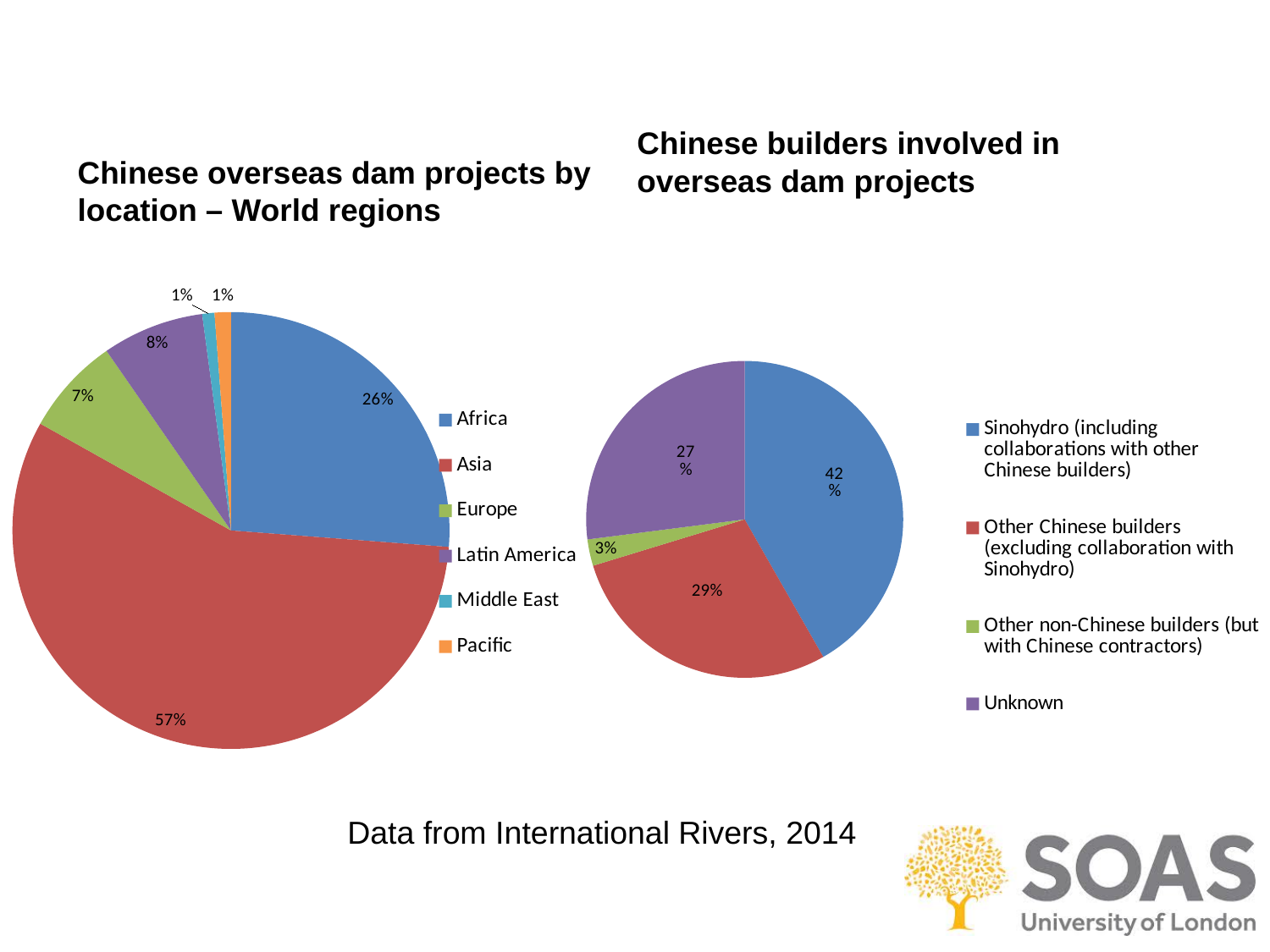
In the 'Chinese overseas dam projects by location – World regions' chart, what share of projects is in Asia? 57% In the 'Chinese builders involved in overseas dam projects' chart, which category has the smallest share? Other non-Chinese builders (but with Chinese contractors) In the 'Chinese overseas dam projects by location – World regions' chart, what share of projects is in Africa? 26% In the 'Chinese builders involved in overseas dam projects' chart, what share is Unknown? 27% In the 'Chinese overseas dam projects by location – World regions' chart, which has the larger share, Europe or Latin America? Latin America In the 'Chinese builders involved in overseas dam projects' chart, what share is attributed to Sinohydro (including collaborations with other Chinese builders)? 42% How many regions are listed in the legend of the 'Chinese overseas dam projects by location – World regions' chart? 6 In the 'Chinese overseas dam projects by location – World regions' chart, what is the difference in percentage points between Asia and Africa? 31 In the 'Chinese overseas dam projects by location – World regions' chart, which region has the largest share? Asia In the 'Chinese builders involved in overseas dam projects' chart, what is the difference in percentage points between Other Chinese builders and Unknown? 2 How many categories does the legend of the 'Chinese builders involved in overseas dam projects' chart list? 4 What type of chart is the 'Chinese overseas dam projects by location – World regions' chart? Pie chart